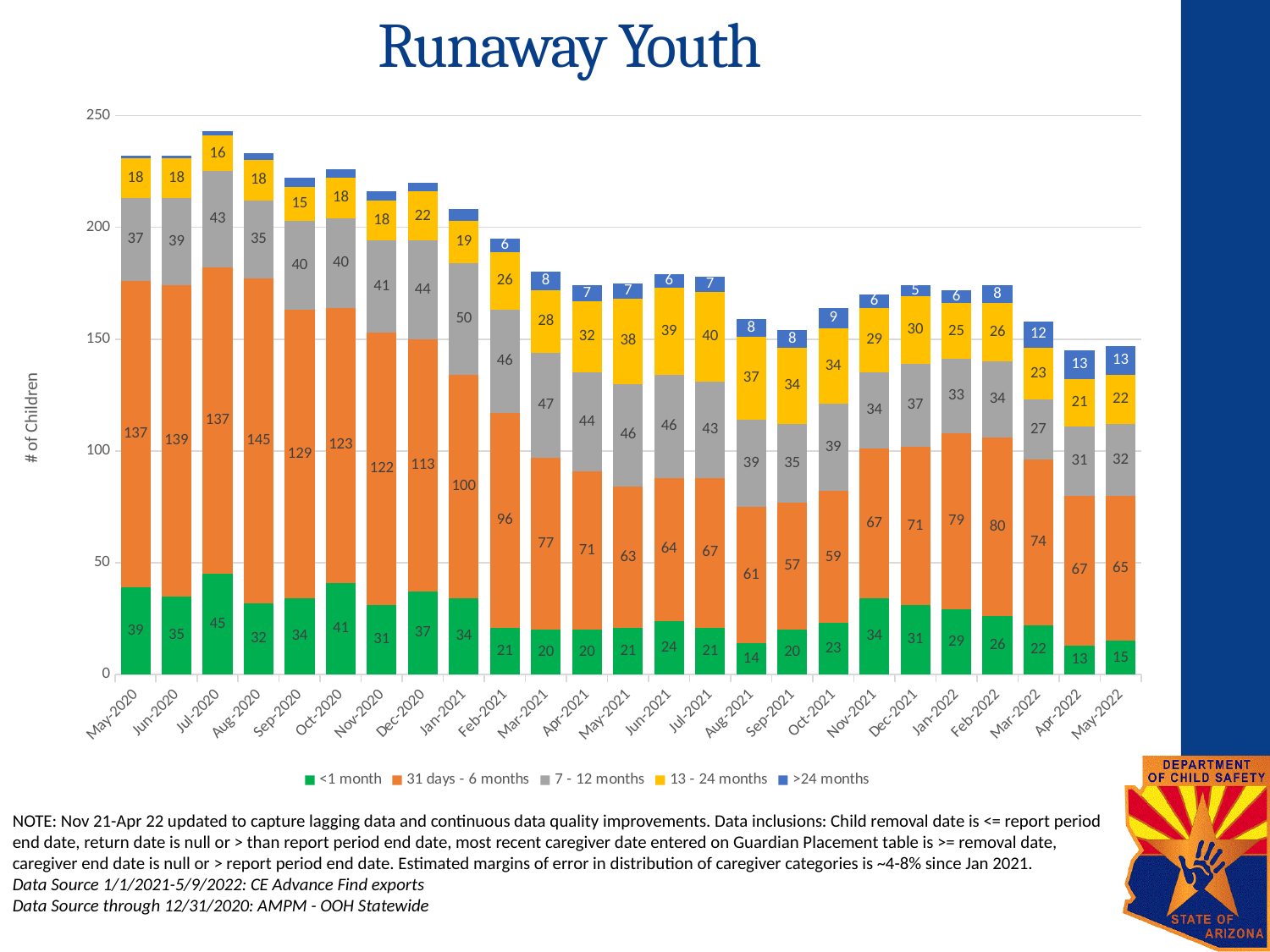
Which is larger, the 13 - 24 months value for Jul-2021 or for Dec-2020? Jul-2021 Which month has the lowest value for the 31 days - 6 months series? Sep-2021 What kind of chart is shown on the slide? Stacked bar chart What is the total of the stacked bar for Feb-2021? 195 What is the value for the <1 month series in Jul-2020? 45 What is the value for the 31 days - 6 months series in Aug-2020? 145 What is the value for the >24 months series in Apr-2022? 13 How many months are shown on the x axis? 25 How many series does the legend list? 5 Which month has the highest value for the 31 days - 6 months series? Aug-2020 Is the total for the May-2020 bar greater or less than 200? greater What is the difference between the 31 days - 6 months values for Aug-2020 and May-2022? 80